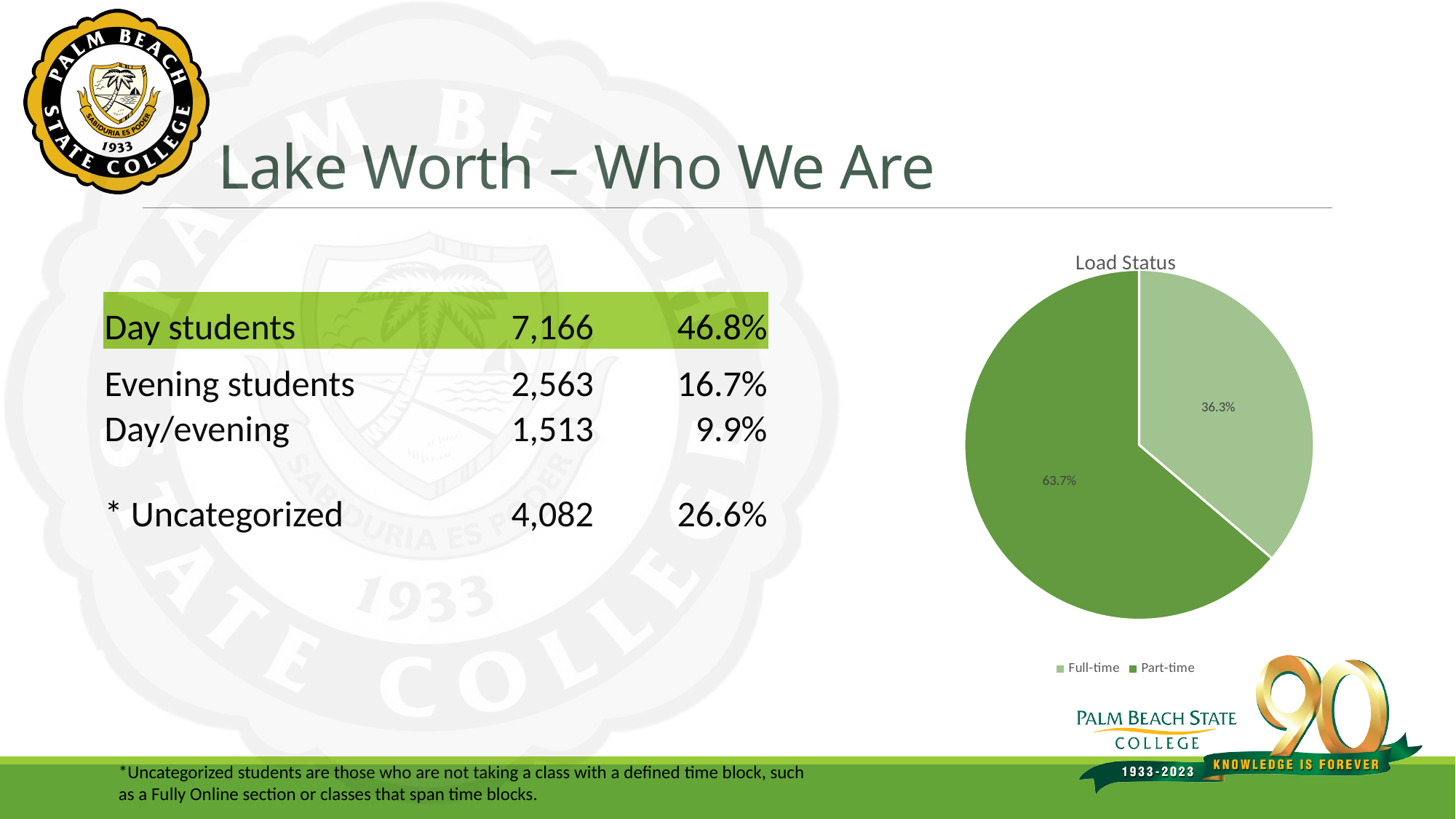
What share of the Load Status pie is Part-time? 63.7% Which slice of the Load Status pie chart is the smallest? Full-time Which legend entry of the Load Status pie chart is shown in the lighter green? Full-time What type of chart is shown on the slide? pie chart How many entries does the legend of the Load Status pie chart list? 2 What is the title of the chart on the slide? Load Status Which slice of the Load Status pie chart is the largest? Part-time How many slices does the Load Status pie chart have? 2 In the Load Status pie chart, which is larger, Full-time or Part-time? Part-time What share of the Load Status pie is Full-time? 36.3% What is the difference in percentage points between the Part-time and Full-time slices of the Load Status pie chart? 27.4